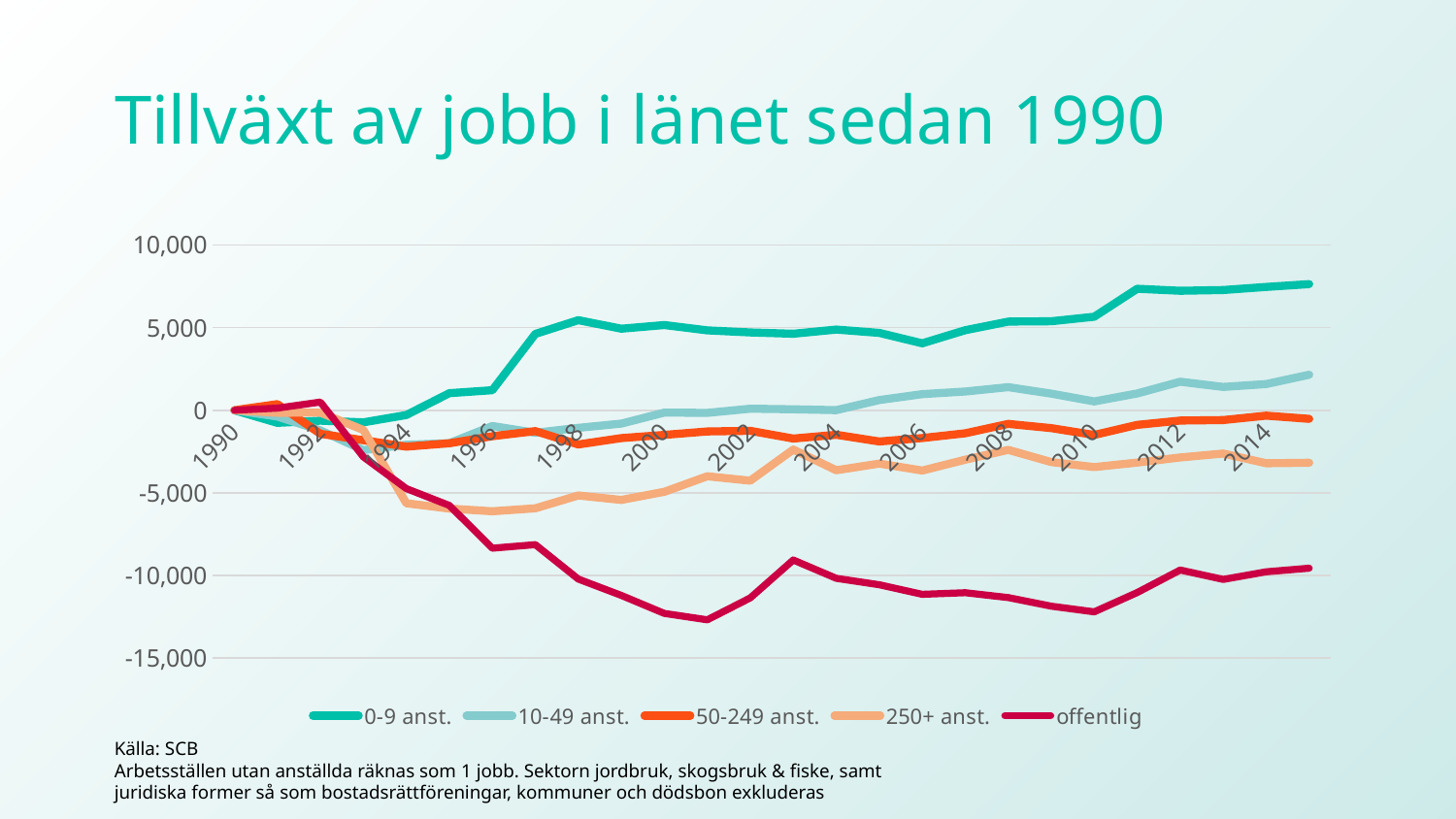
Is the value for offentlig in 2000 greater or less than -10,000? less Is the value for 0-9 anst. in 2012 greater or less than 5,000? greater Does the offentlig line rise or fall from 1990 to 2000? fall Which series has the highest value in 2014? 0-9 anst. What source is cited below the chart? SCB Is the value for 250+ anst. in 1996 greater or less than -5,000? less How many series does the legend list? 5 What is the title of the chart? Tillväxt av jobb i länet sedan 1990 Which series has the lowest value in 2014? offentlig In 2014, which is higher, 0-9 anst. or 10-49 anst.? 0-9 anst. What kind of chart is shown on the slide? line chart